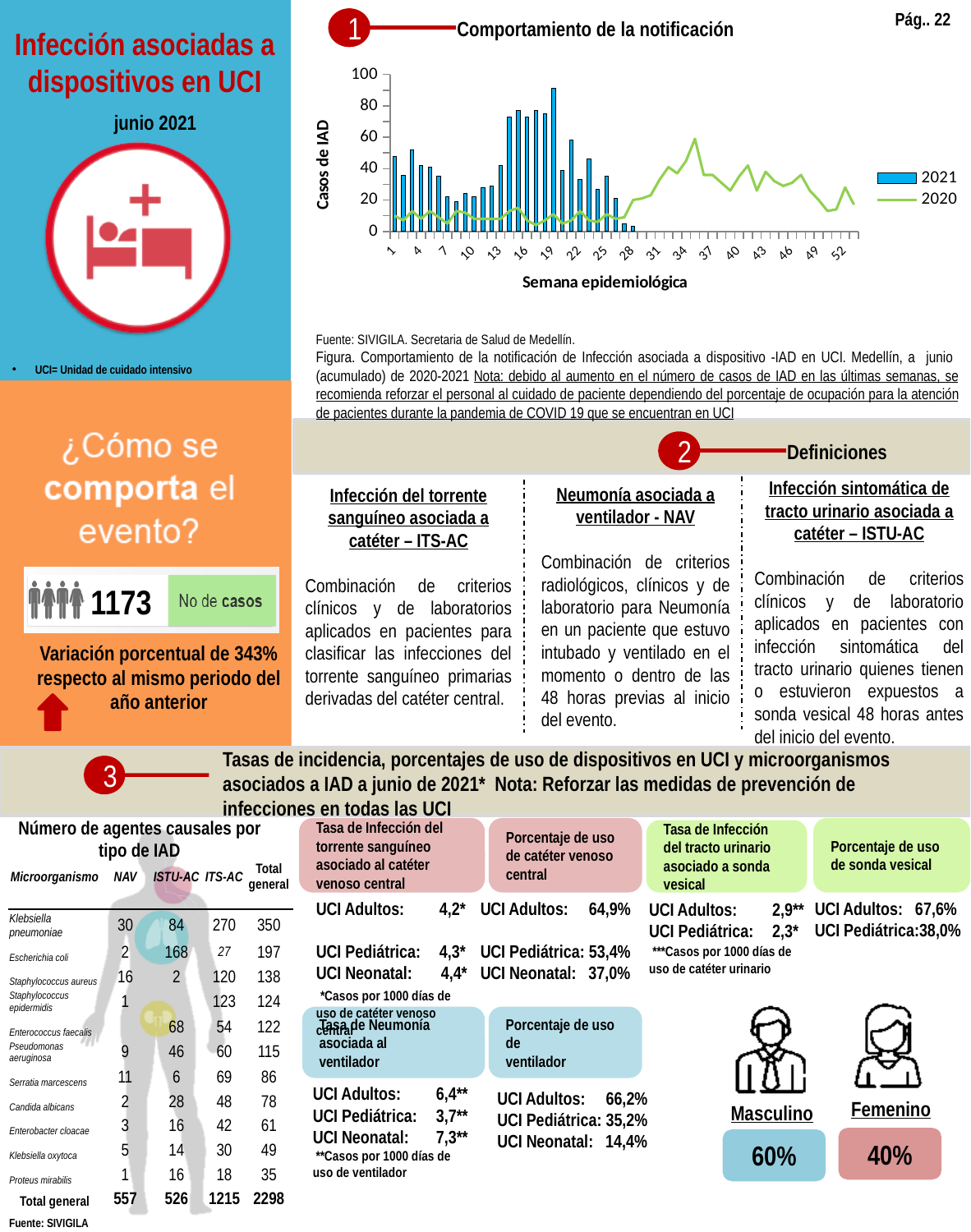
What are the two series named in the legend of the 'Comportamiento de la notificación' chart? 2021 and 2020 In the 'Comportamiento de la notificación' chart, which series has the larger value at week 1, 2021 or 2020? 2021 In the 'Comportamiento de la notificación' chart, is the 2021 value at week 19 greater or less than 80? greater In the 'Comportamiento de la notificación' chart, is the 2020 value at week 1 greater or less than 20? less In the 'Comportamiento de la notificación' chart, at which epidemiological week is the 2021 bar highest? Week 19 In the 'Comportamiento de la notificación' chart, is the 2021 value at week 1 greater or less than 60? less What kind of chart is 'Comportamiento de la notificación'? A combined bar and line chart What is the title of the x axis of the 'Comportamiento de la notificación' chart? Semana epidemiológica How many series does the legend of the 'Comportamiento de la notificación' chart list? 2 In the 'Comportamiento de la notificación' chart, do the 2021 bars rise or fall from week 19 to week 28? fall